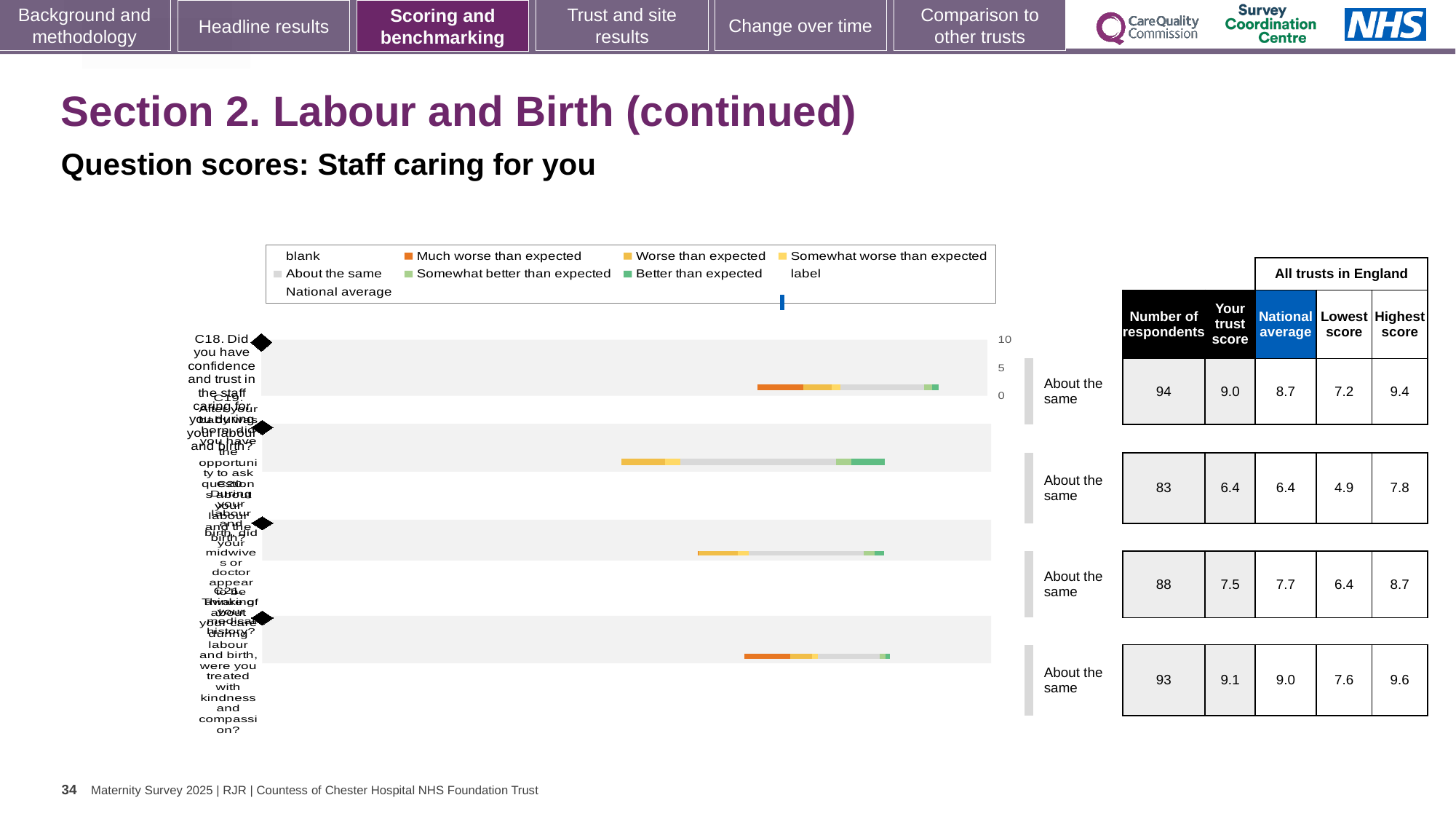
In the table beside the chart, which row has the highest 'Your trust score'? the bottom row (9.1) What benchmark label is shown beside each of the four rows? About the same For the top row (C18), which is larger: the trust score or the national average? the trust score (9.0) In the table beside the chart, what is the national average for the second row? 6.4 How many question bars are plotted in the chart? 4 In the table beside the chart, which row has the lowest 'Your trust score'? the second row (6.4) In the chart legend, what colour represents 'Much worse than expected'? orange In the table beside the chart, what is the 'Your trust score' for the top row (C18)? 9.0 In the table beside the chart, what is the difference between the highest score and the lowest score for the top row (C18)? 2.2 In the chart legend, what colour represents 'Better than expected'? green What kind of chart is shown on the slide? bar chart In the table beside the chart, what is the number of respondents for the top row (C18)? 94